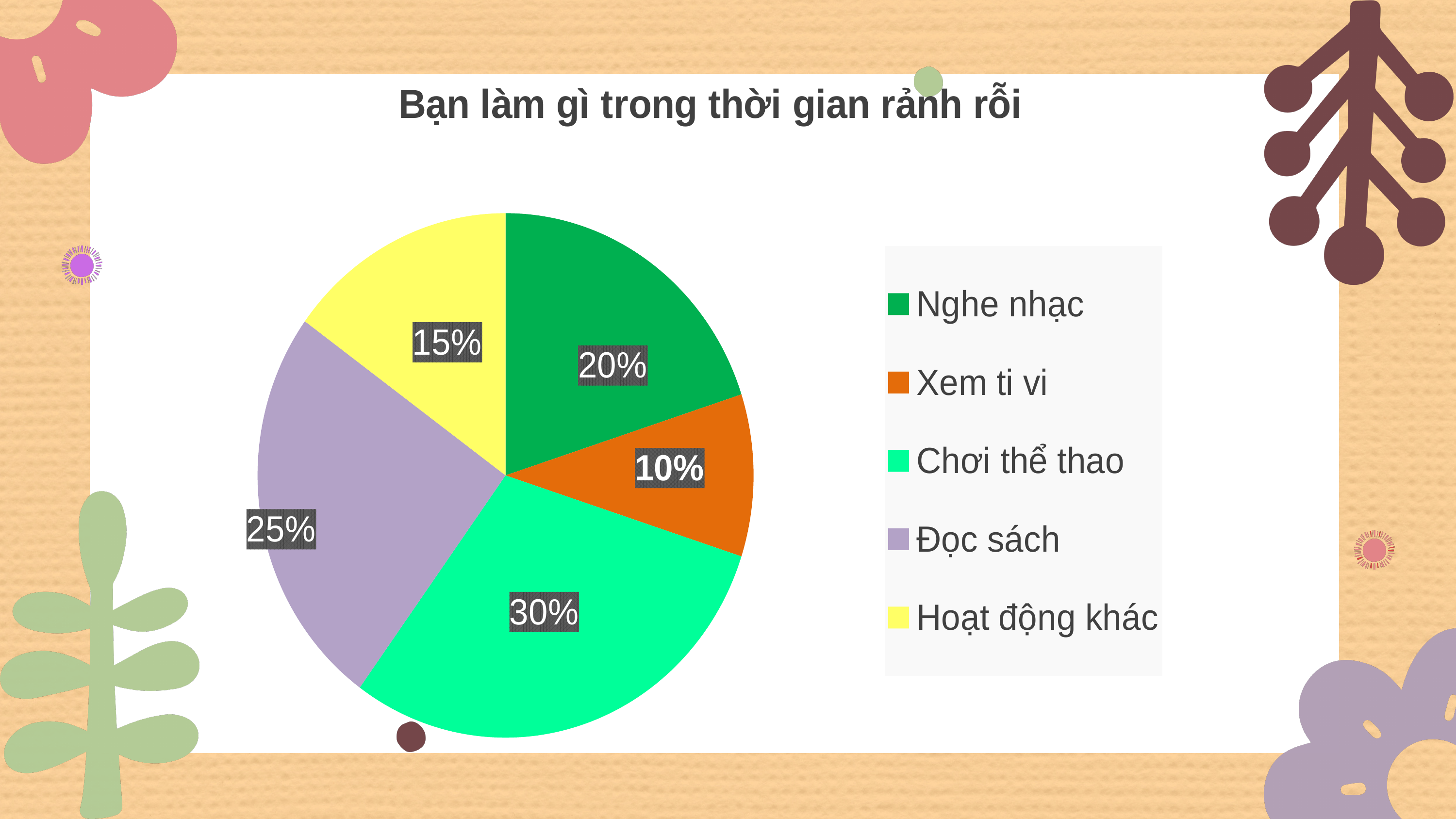
Which is larger, the share for Đọc sách or the share for Hoạt động khác? Đọc sách What percentage of the pie is Chơi thể thao? 30% What percentage of the pie is Xem ti vi? 10% Which category has the smallest share of the pie? Xem ti vi What percentage of the pie is Nghe nhạc? 20% What percentage of the pie is Hoạt động khác? 15% How many categories does the legend list? 5 What is the difference between the shares of Chơi thể thao and Nghe nhạc? 10% What type of chart is shown on the slide? pie chart What is the title of the chart? Bạn làm gì trong thời gian rảnh rỗi Which category has the largest share of the pie? Chơi thể thao What percentage of the pie is Đọc sách? 25%